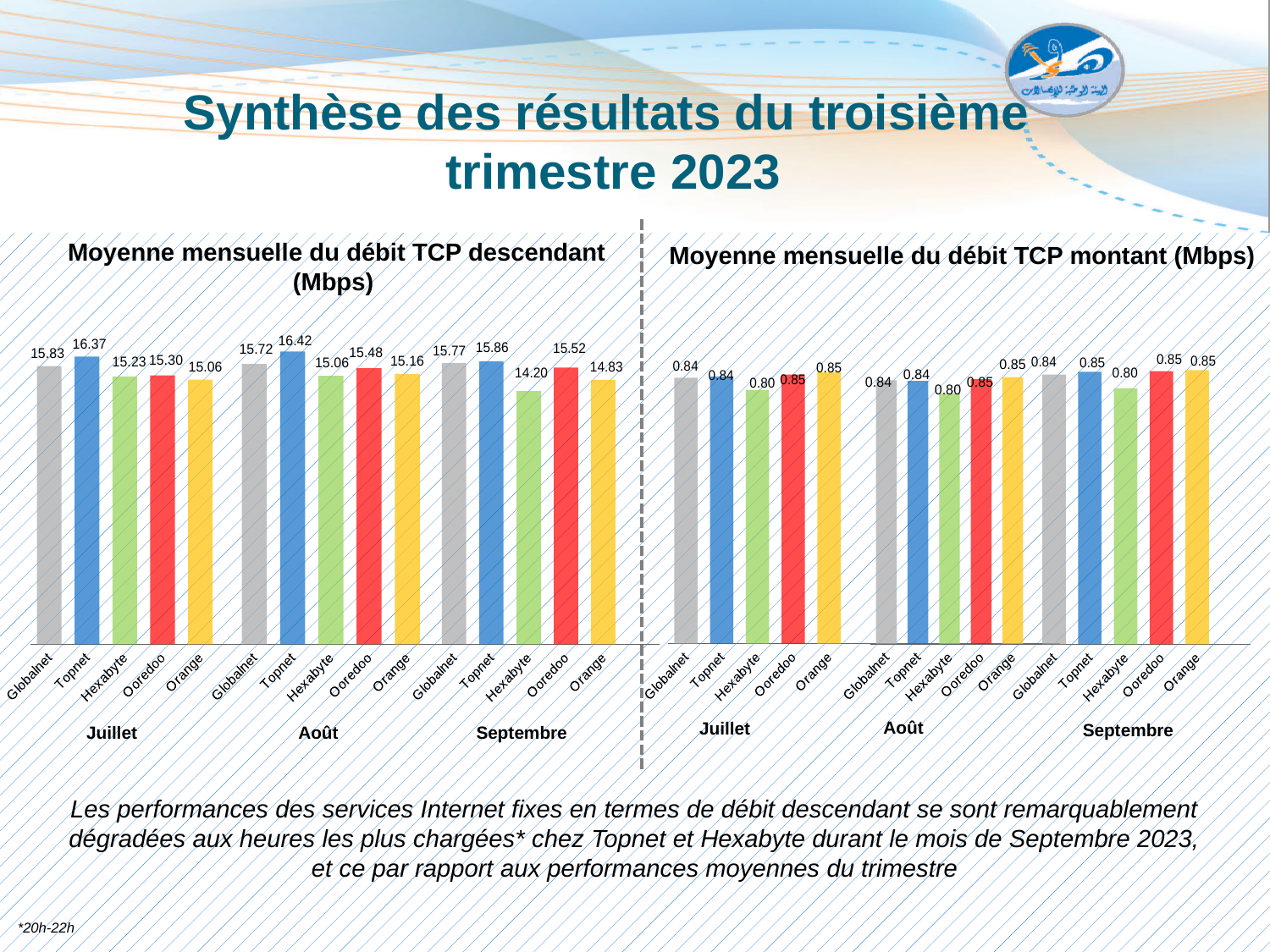
What kind of chart is 'Moyenne mensuelle du débit TCP montant (Mbps)'? Bar chart In the chart 'Moyenne mensuelle du débit TCP descendant (Mbps)', what is the difference between Topnet and Hexabyte in Septembre? 1.66 In the chart 'Moyenne mensuelle du débit TCP descendant (Mbps)', which operator has the highest value in Août? Topnet In the chart 'Moyenne mensuelle du débit TCP descendant (Mbps)', what is the value for Hexabyte in Septembre? 14.20 In the chart 'Moyenne mensuelle du débit TCP descendant (Mbps)', what is the value for Topnet in Juillet? 16.37 In the chart 'Moyenne mensuelle du débit TCP montant (Mbps)', which operator has the lowest value in Août? Hexabyte In the chart 'Moyenne mensuelle du débit TCP descendant (Mbps)', does the value for Hexabyte rise or fall from Juillet to Septembre? Fall How many bars are plotted in the chart 'Moyenne mensuelle du débit TCP descendant (Mbps)'? 15 In the chart 'Moyenne mensuelle du débit TCP descendant (Mbps)', which is larger: Ooredoo in Août or Orange in Août? Ooredoo in Août In the chart 'Moyenne mensuelle du débit TCP descendant (Mbps)', which operator has the lowest value in Septembre? Hexabyte In the chart 'Moyenne mensuelle du débit TCP montant (Mbps)', what is the value for Hexabyte in Juillet? 0.80 In the chart 'Moyenne mensuelle du débit TCP montant (Mbps)', what is the value for Orange in Septembre? 0.85